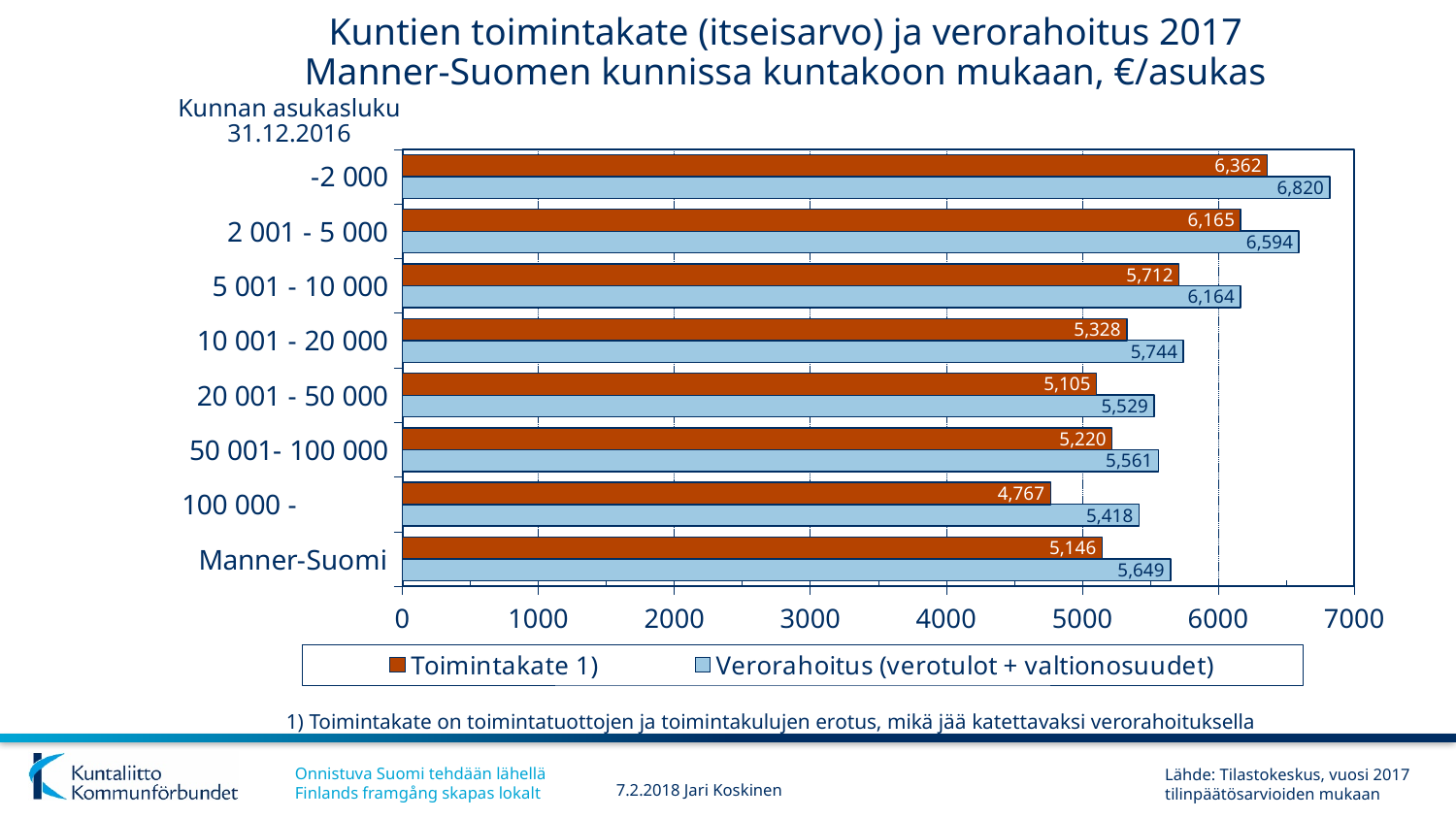
What is the difference between the Verorahoitus and Toimintakate values for the 5 001 - 10 000 group? 452 What is the Verorahoitus value for the 100 000 - population group? 5,418 Which population group has the lowest Toimintakate value? 100 000 - How many series does the legend list? 2 What is the Verorahoitus value for the 10 001 - 20 000 population group? 5,744 Which population group has the highest Verorahoitus value? -2 000 How many categories are shown on the vertical axis of the chart? 8 What is the Toimintakate value for municipalities with population -2 000? 6,362 Is the Toimintakate value for the 100 000 - group greater or less than 5000? less What type of chart is shown on the slide? Bar chart What is the Toimintakate value for Manner-Suomi? 5,146 Which is larger: the Toimintakate value for 20 001 - 50 000 or for 50 001- 100 000? 50 001- 100 000